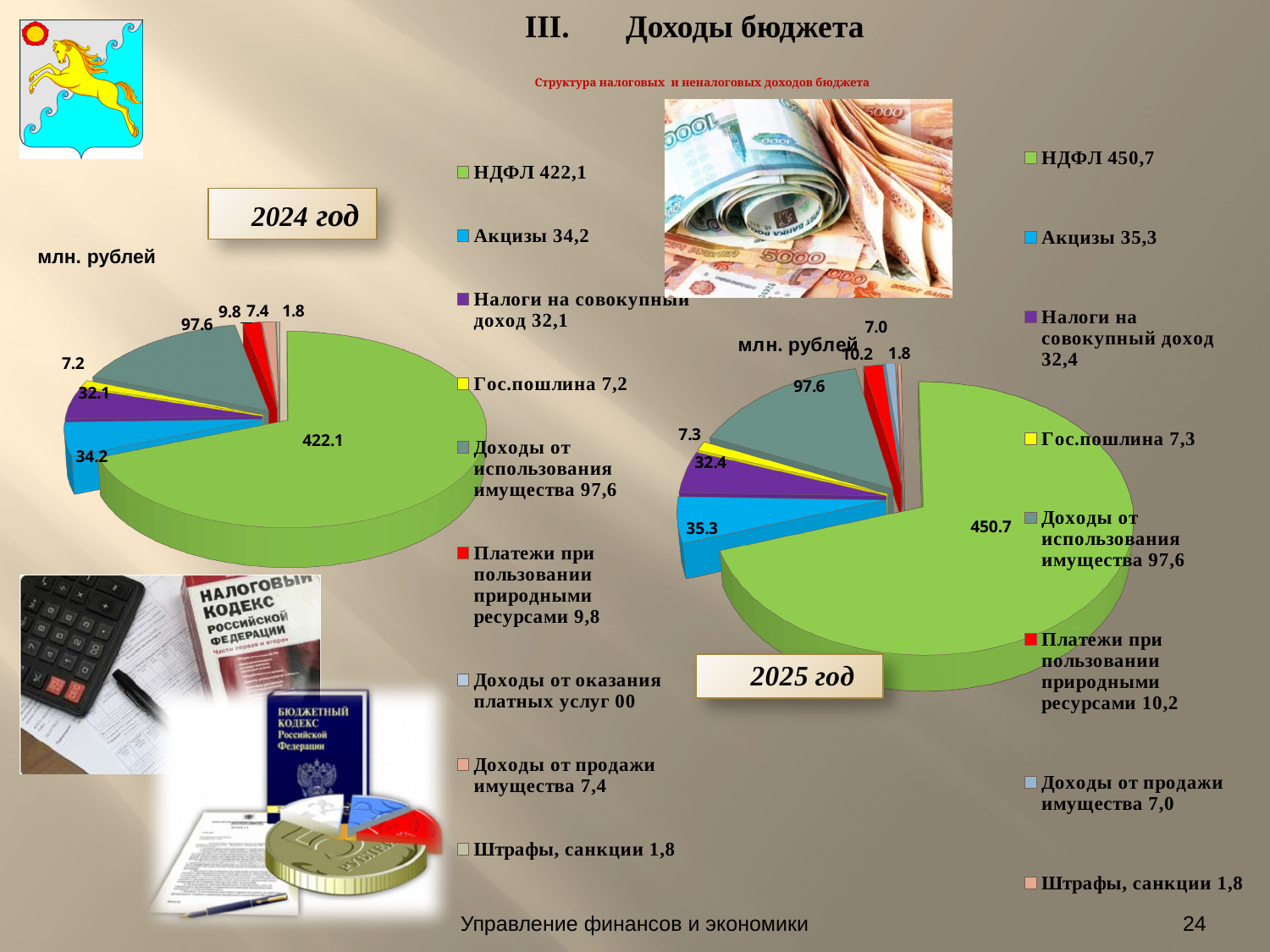
In the 2024 год pie chart, what is the value for НДФЛ? 422.1 In the 2025 год pie chart, which category has the largest slice? НДФЛ What type of chart is used for the 2025 год data? Pie chart In the 2024 год pie chart, what is the value for Доходы от оказания платных услуг? 00 What is the difference between the НДФЛ value in the 2025 год chart and the НДФЛ value in the 2024 год chart? 28.6 How many entries does the legend of the 2024 год chart list? 9 In the 2025 год pie chart, which is larger: Акцизы or Налоги на совокупный доход? Акцизы In the 2024 год pie chart, which category has the smallest non-zero value? Штрафы, санкции In the 2024 год pie chart, what is the value for Доходы от использования имущества? 97.6 In the 2025 год pie chart, what is the value for Платежи при пользовании природными ресурсами? 10.2 In the 2025 год pie chart, what is the value for Акцизы? 35.3 In the 2024 год pie chart, what is the difference between Доходы от использования имущества and Акцизы? 63.4